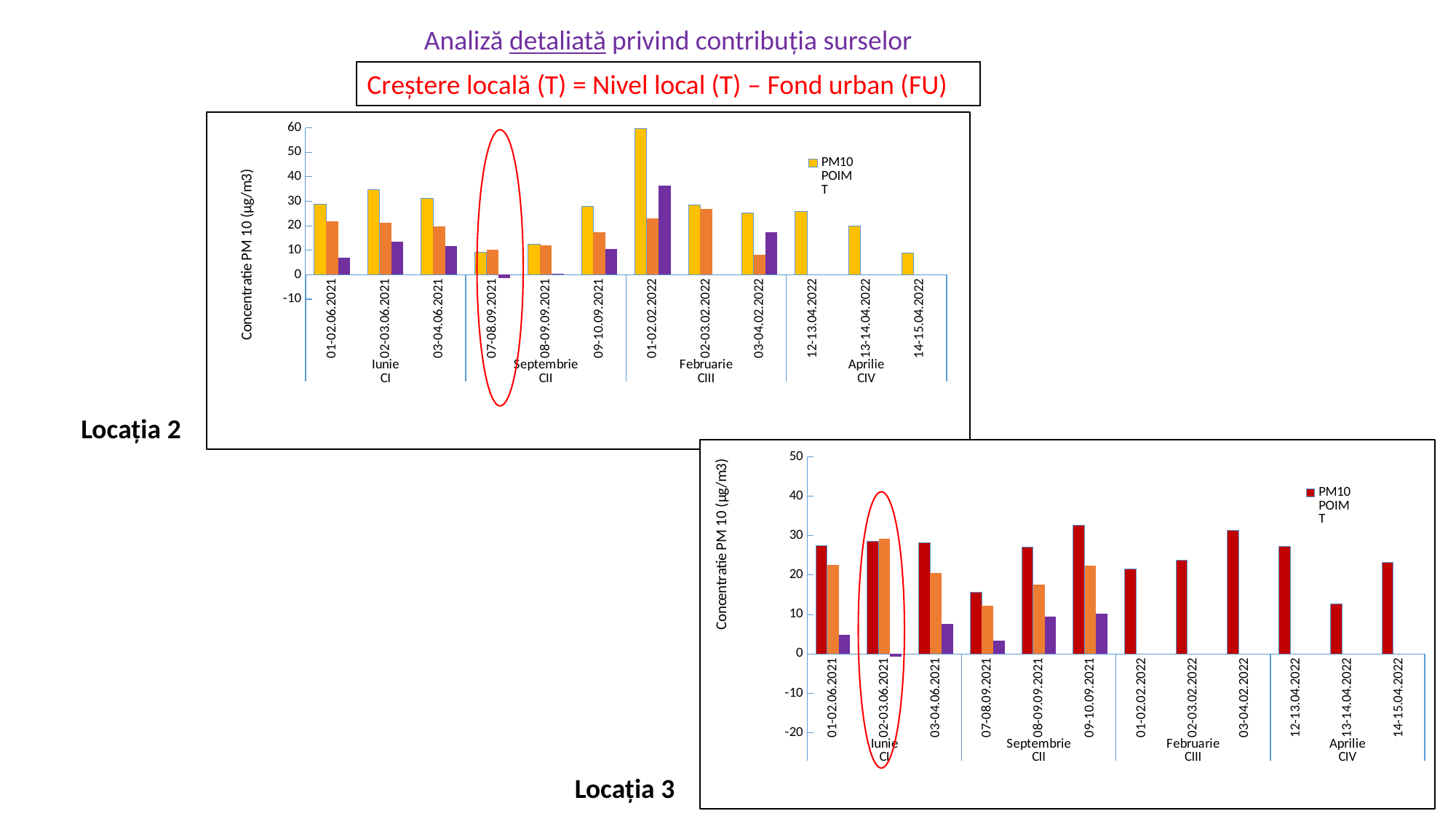
How many date categories are shown on the x axis of the Locația 2 chart? 12 In the Locația 2 chart, is the PM10 value for 01-02.02.2022 greater or less than 50? greater In the Locația 2 chart, is the PM10 value for 14-15.04.2022 greater or less than 10? less What kind of chart is the Locația 2 chart? bar chart In the Locația 3 chart, is the PM10 value for 09-10.09.2021 greater or less than 30? greater What is the y-axis label of the Locația 3 chart? Concentratie PM 10 (µg/m3) In the Locația 3 chart, which date is circled in red? 02-03.06.2021 How many series does the legend of the Locația 3 chart list? 1 In the Locația 3 chart, which is larger, the PM10 value for 01-02.06.2021 or for 07-08.09.2021? 01-02.06.2021 In the Locația 2 chart, which date has the highest PM10 value? 01-02.02.2022